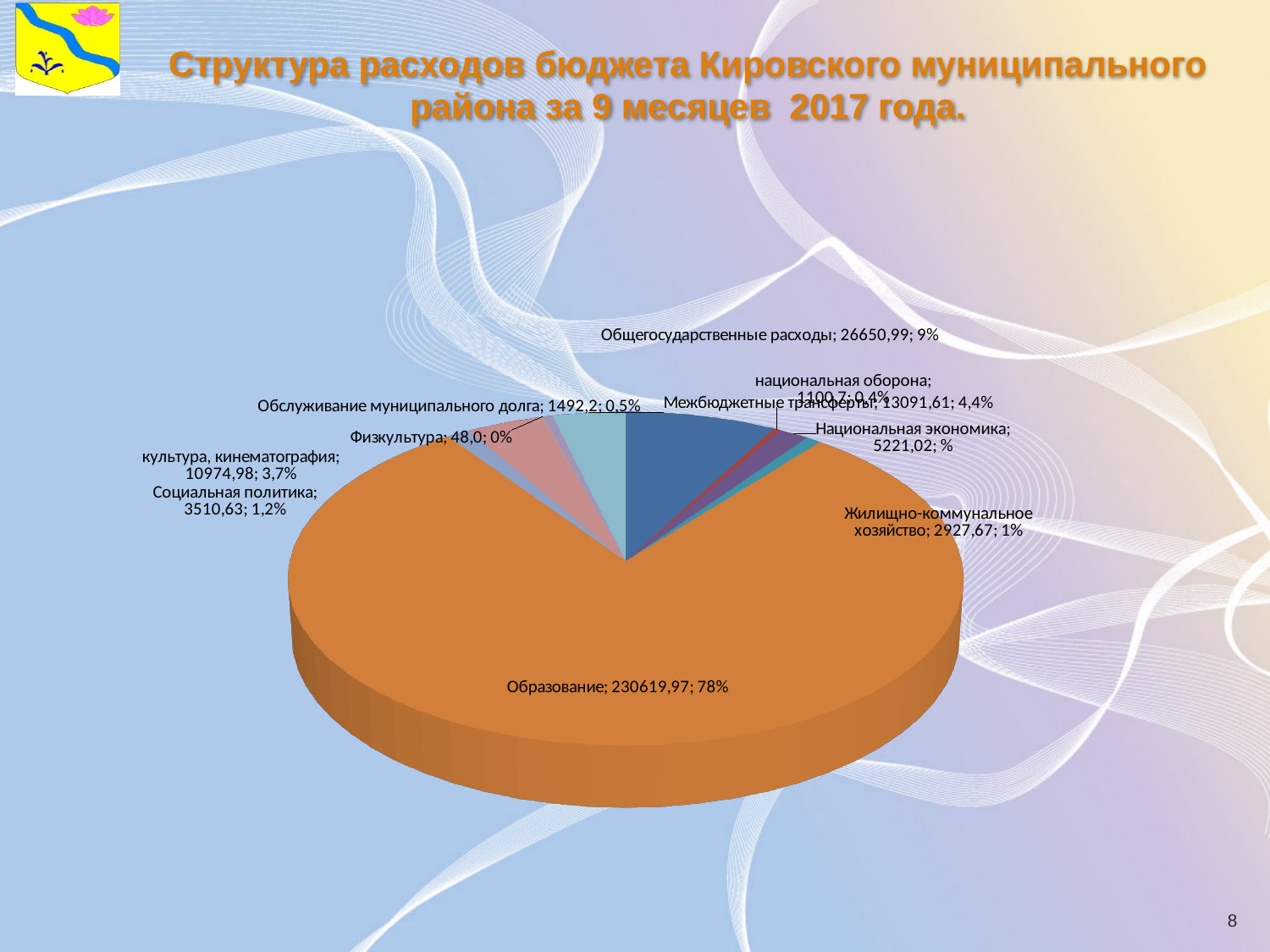
How many categories are shown in the pie chart? 10 Which category has the largest slice of the pie? Образование What is the value shown for Национальная экономика? 5221,02 What period does the slide title say the expenditure structure covers? 9 месяцев 2017 года What is the value shown for Образование? 230619,97 What is the value shown for Общегосударственные расходы? 26650,99 What kind of chart is shown on the slide? pie chart Which is larger: культура, кинематография or Социальная политика? культура, кинематография What percentage share is shown for Межбюджетные трансферты? 4,4% What share of the pie does Образование account for? 78% What is the difference between the values for Общегосударственные расходы and Межбюджетные трансферты? 13559,38 Which category has the smallest value in the pie chart? Физкультура